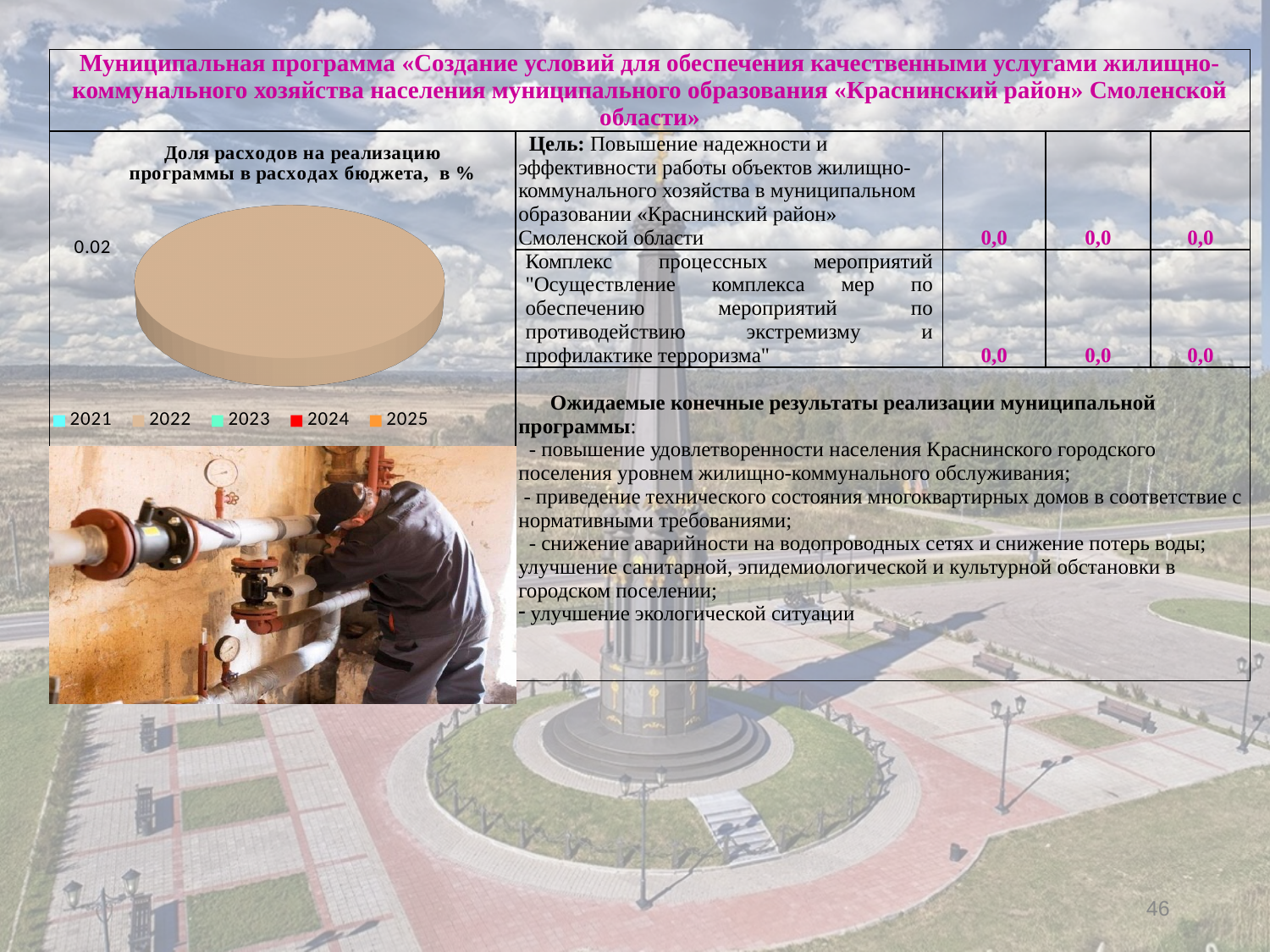
What is the title of the chart on the slide? Доля расходов на реализацию программы в расходах бюджета, в % What data label value is printed next to the pie chart? 0.02 How many slices are visible in the pie chart? 1 Which years are listed in the chart's legend? 2021, 2022, 2023, 2024, 2025 Which legend entry matches the colour of the visible pie slice? 2022 What kind of chart is shown on the slide? pie chart How many entries does the chart's legend list? 5